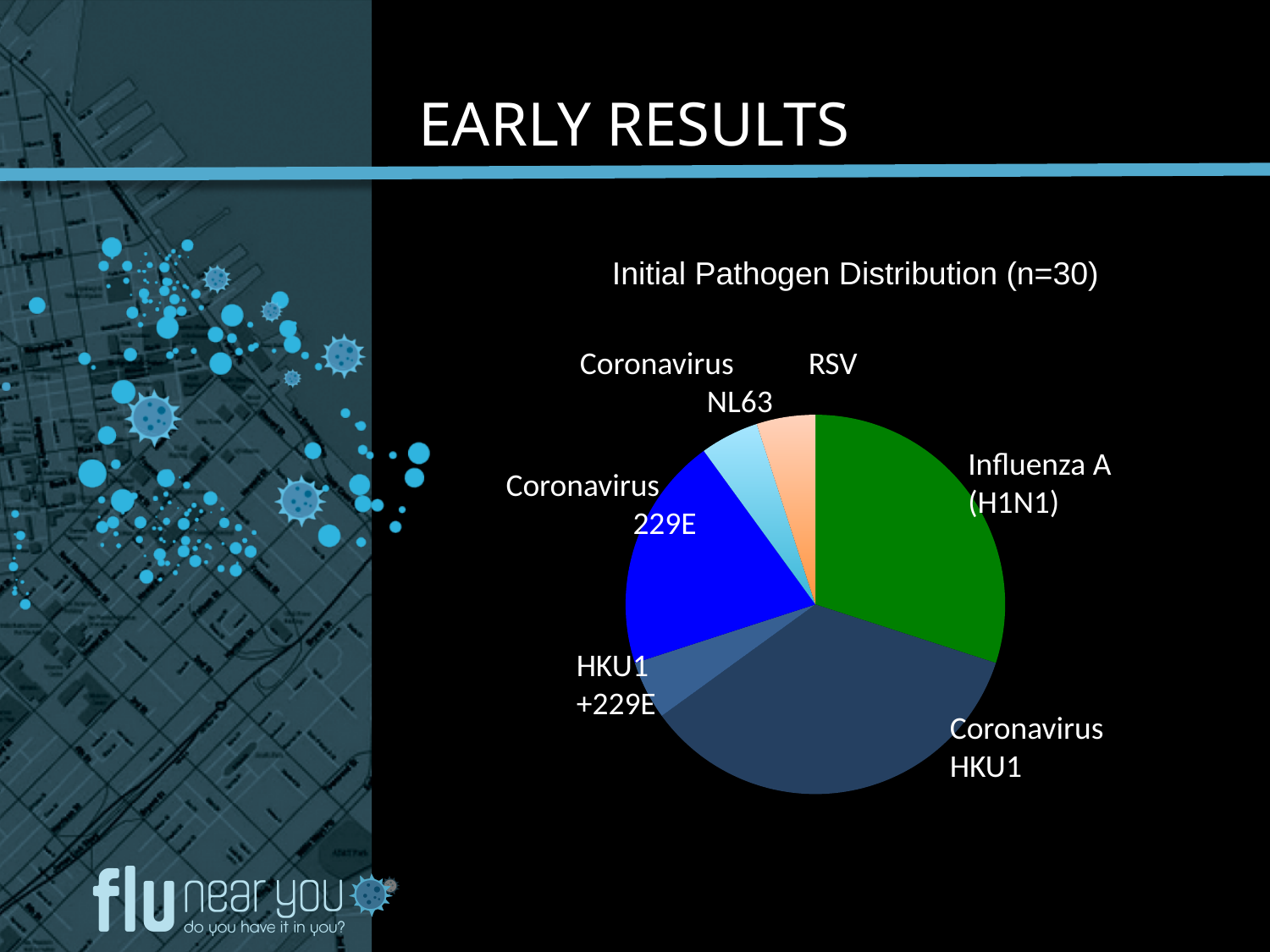
Which slice is larger, Coronavirus 229E or HKU1 +229E? Coronavirus 229E Which slice is larger, Coronavirus HKU1 or HKU1 +229E? Coronavirus HKU1 Which slice is larger, Influenza A (H1N1) or RSV? Influenza A (H1N1) Which pathogen has the largest slice of the pie chart? Coronavirus HKU1 What sample size (n) is stated in the chart title? 30 What kind of chart is shown on the slide? Pie chart What is the title of the chart? Initial Pathogen Distribution (n=30) How many pathogen categories (slices) does the pie chart show? 6